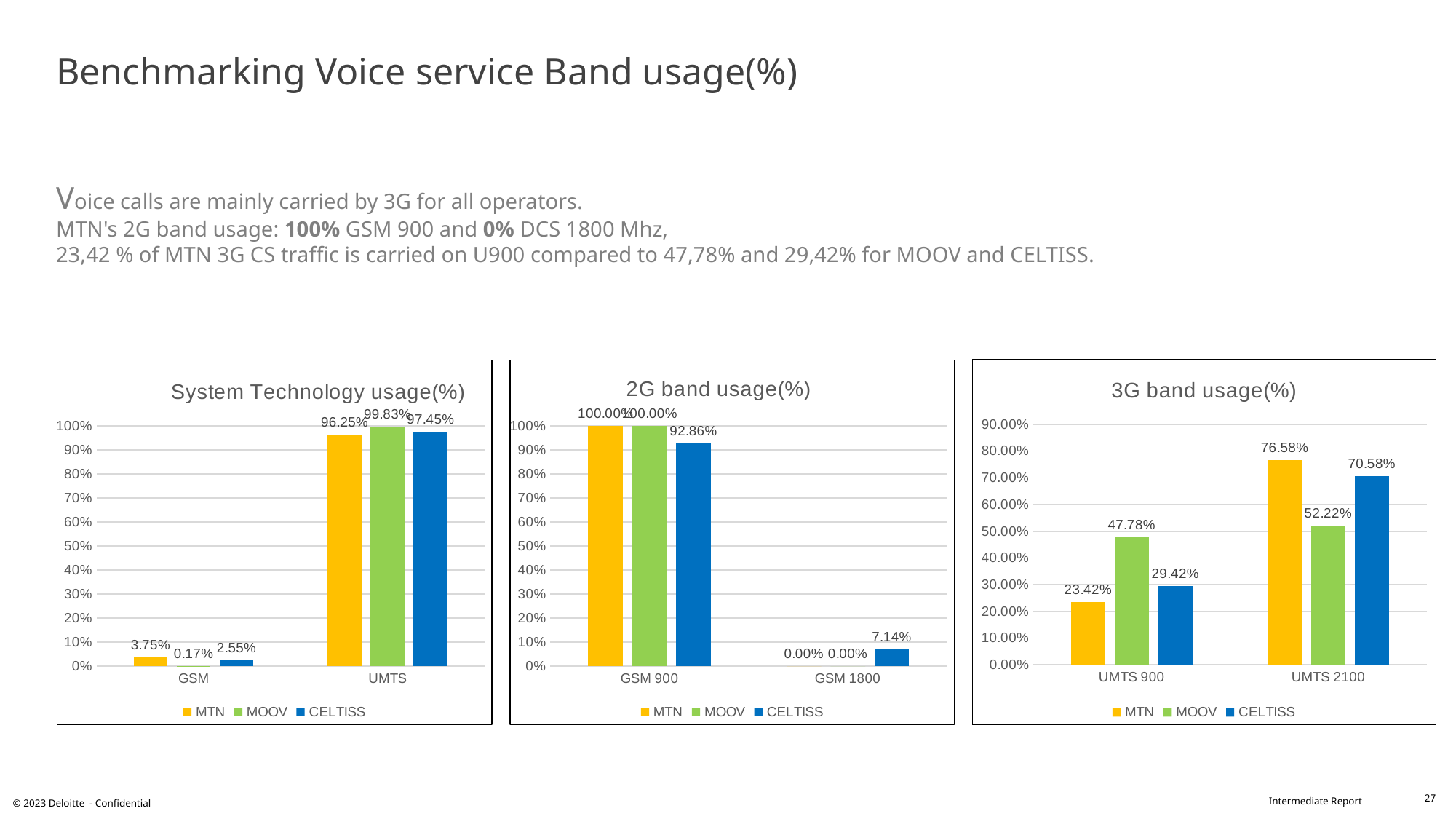
In the "3G band usage(%)" chart, which operator has the highest value for UMTS 2100? MTN In the "System Technology usage(%)" chart, which operator has the lowest value for GSM? MOOV In the "2G band usage(%)" chart, what is the value for CELTISS in the GSM 1800 category? 7.14% In the "System Technology usage(%)" chart, which operator has the highest value for UMTS? MOOV In the "System Technology usage(%)" chart, what is the value for MTN in the GSM category? 3.75% In the "2G band usage(%)" chart, what is the value for CELTISS in the GSM 900 category? 92.86% In the "2G band usage(%)" chart, what is the difference between MTN and CELTISS for GSM 900? 7.14% In the "3G band usage(%)" chart, is the value for CELTISS in UMTS 2100 larger or smaller than the value for MOOV in UMTS 2100? larger In the "3G band usage(%)" chart, what is the value for MOOV in the UMTS 900 category? 47.78% What kind of chart is the "2G band usage(%)" chart? bar chart In the "3G band usage(%)" chart, what is the difference between MTN's UMTS 2100 and UMTS 900 values? 53.16% How many series does the legend of the "3G band usage(%)" chart list? 3